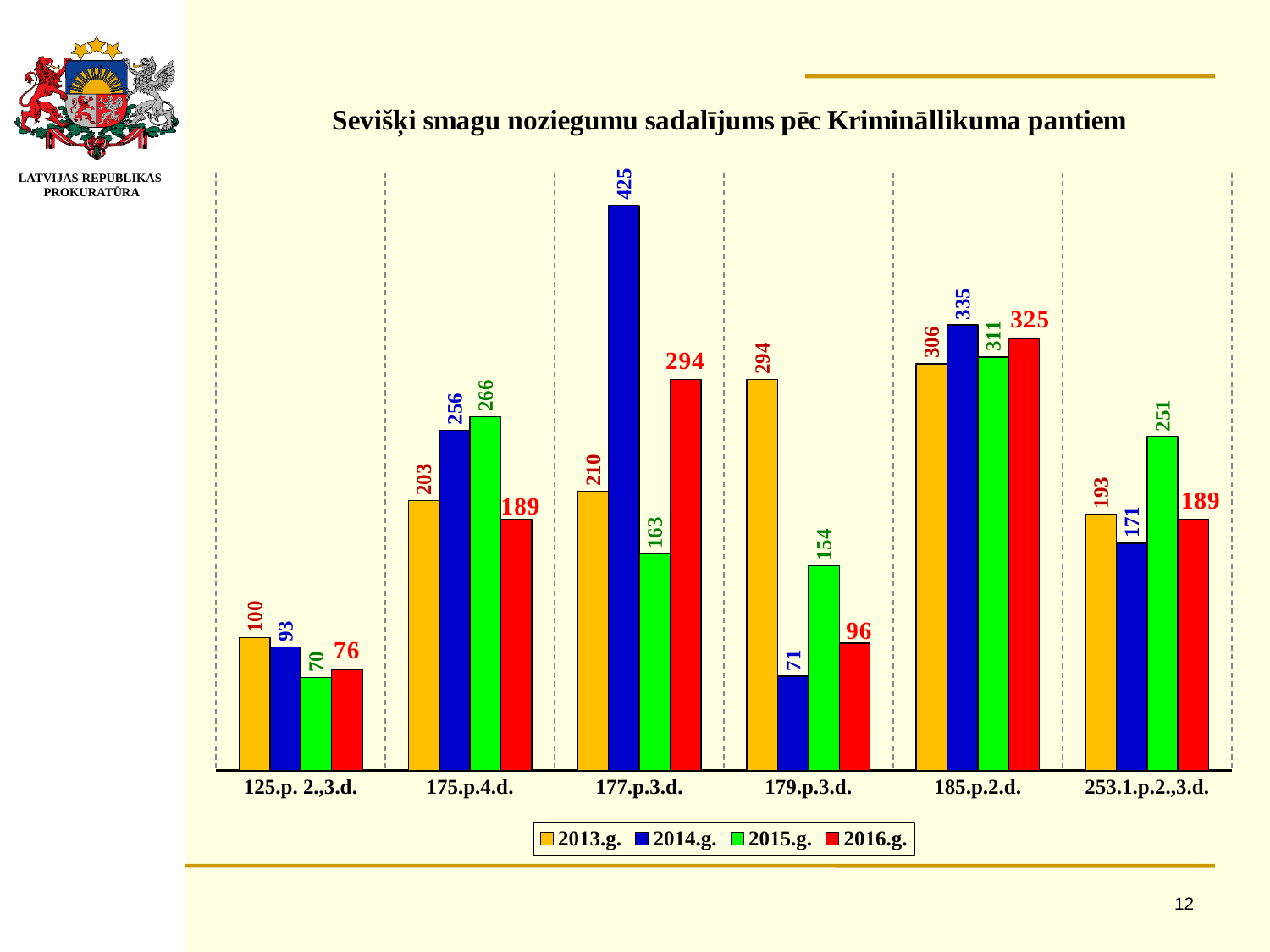
How many categories are shown on the x axis? 6 What is the difference between the 2014.g. and 2016.g. values in the 177.p.3.d. category? 131 Which category has the lowest value for 2014.g.? 179.p.3.d. What is the value for 2015.g. in the 253.1.p.2.,3.d. category? 251 What is the value for 2014.g. in the 177.p.3.d. category? 425 Which category has the highest value for 2013.g.? 185.p.2.d. What kind of chart is shown on the slide? Bar chart What is the title of the chart? Sevišķi smagu noziegumu sadalījums pēc Krimināllikuma pantiem How many series does the legend list? 4 What is the difference between the 2013.g. and 2015.g. values in the 179.p.3.d. category? 140 What is the value for 2016.g. in the 185.p.2.d. category? 325 Which is larger in the 175.p.4.d. category: the 2014.g. value or the 2015.g. value? 2015.g.